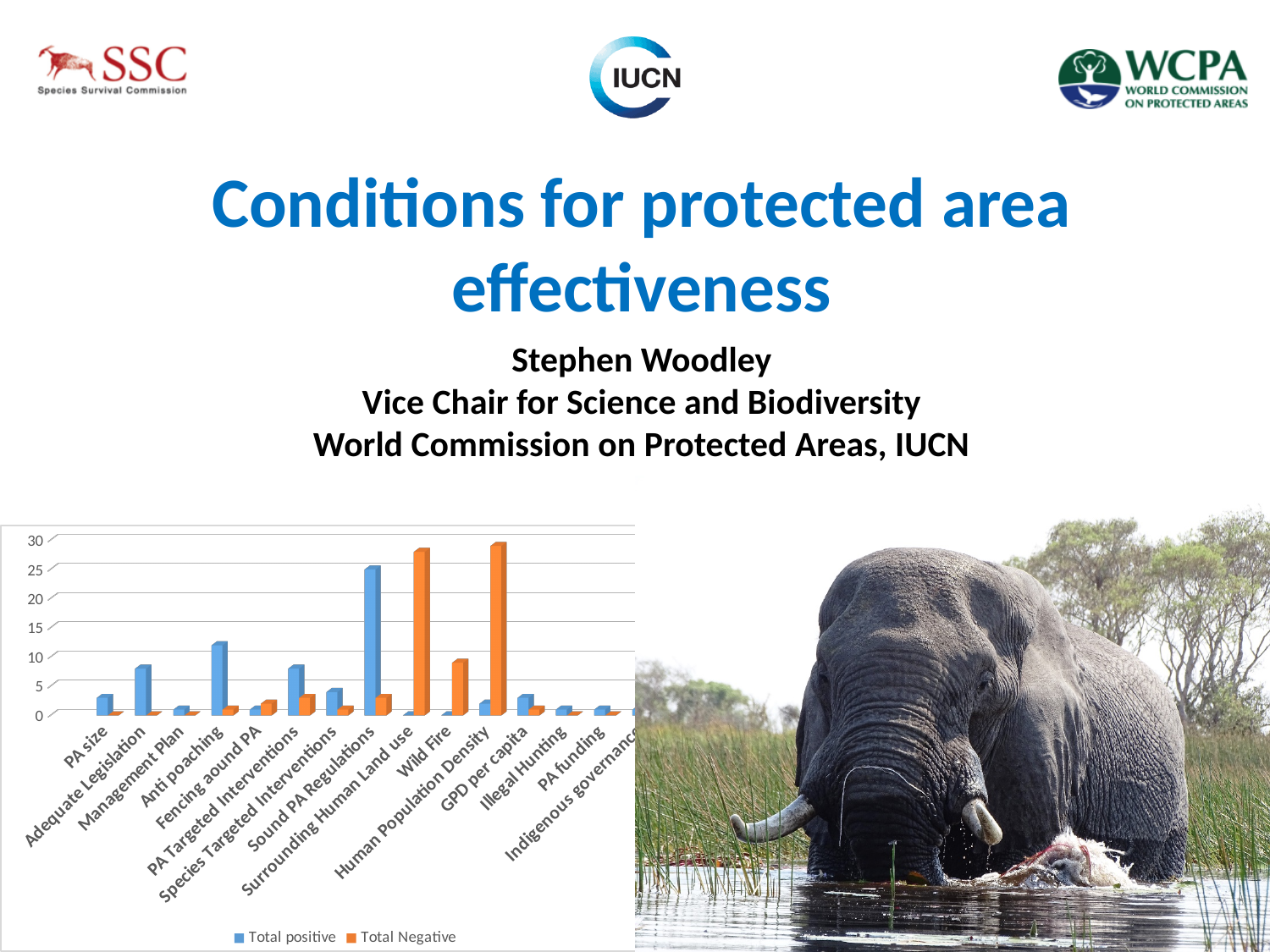
Is the Total positive value for Sound PA Regulations greater or less than 20? greater Which category has the highest Total positive value? Sound PA Regulations Which colour represents the Total positive series in the chart? blue What are the two series named in the chart legend? Total positive and Total Negative Which is larger: the Total positive value for Sound PA Regulations or the Total positive value for Anti poaching? Sound PA Regulations Is the Total Negative value for Surrounding Human Land use greater or less than 25? greater How many series does the chart legend list? 2 Is the Total positive value for PA size greater or less than 5? less What kind of chart is shown on the slide? bar chart Which is larger: the Total Negative value for Surrounding Human Land use or the Total Negative value for Wild Fire? Surrounding Human Land use